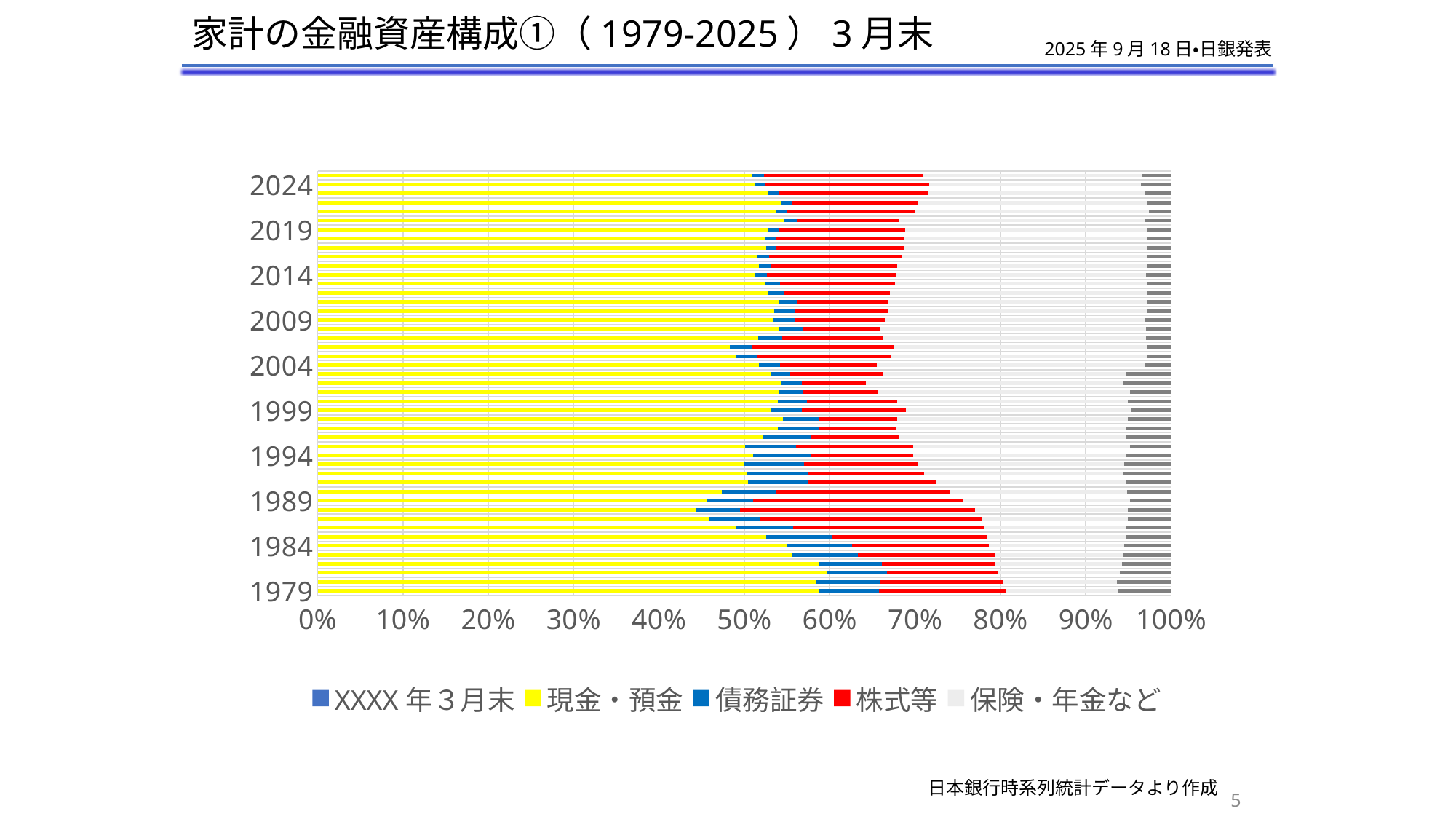
What is the title of the chart on the slide? 家計の金融資産構成①（1979-2025）3月末 Which year has the larger 株式等 share, 1989 or 2009? 1989 Is the 現金・預金 share for 1979 greater or less than 50%? greater Which year has the larger 現金・預金 share, 1989 or 2014? 2014 How many year labels are shown on the vertical axis? 10 Is the 現金・預金 share for 2009 greater or less than 50%? greater Does the 現金・預金 share rise or fall from 1979 to 1989? fall Is the 現金・預金 share for 1984 greater or less than 60%? less How many entries does the legend list? 5 What kind of chart is shown on the slide? Stacked bar chart Which legend entry is shown in yellow? 現金・預金